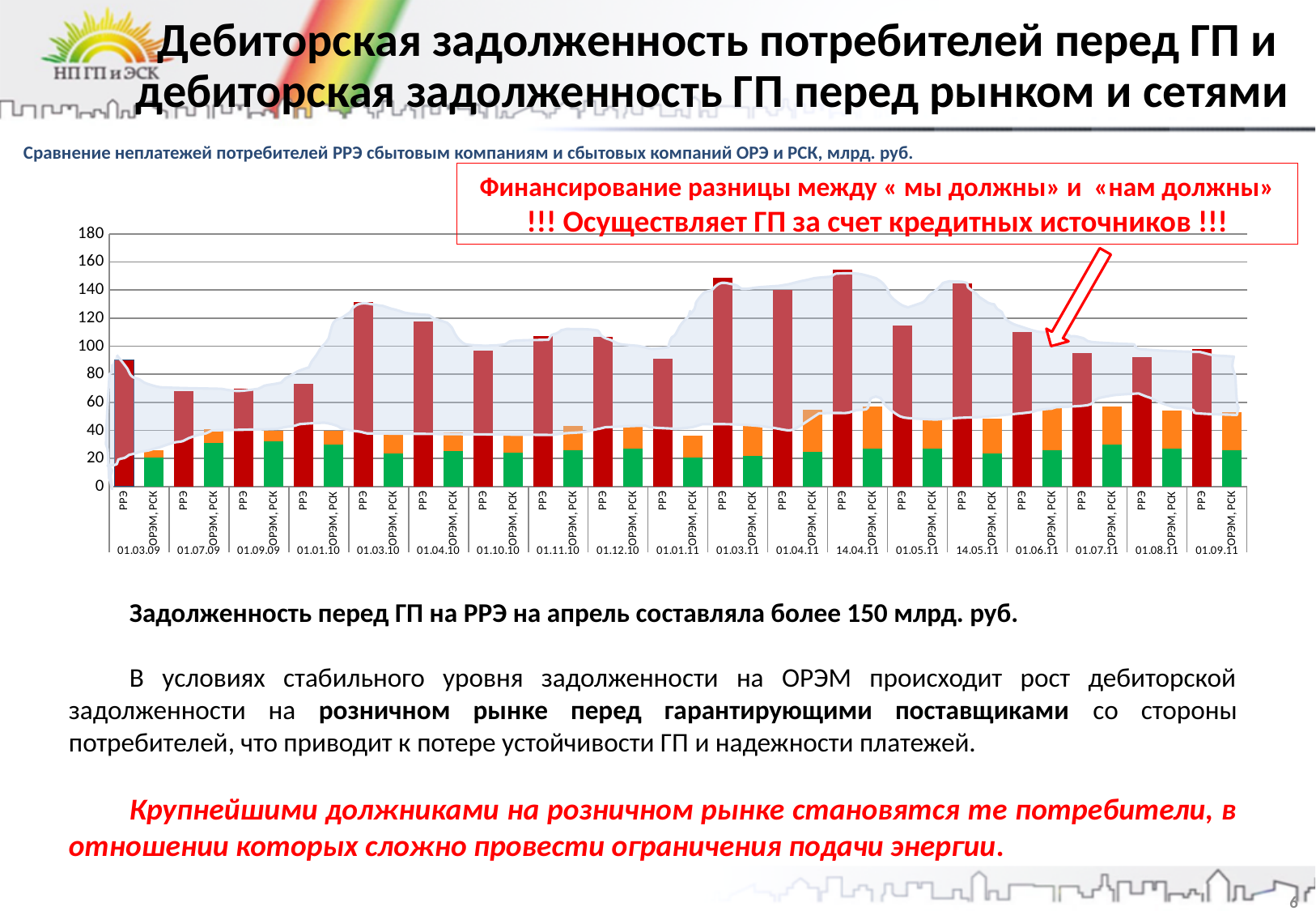
Do the РРЭ values rise or fall from 01.09.09 to 01.03.10? rise Is the РРЭ value for 01.03.09 greater or less than 80? greater What is the highest value shown on the vertical axis of the chart? 180 Is the РРЭ value for 01.05.11 greater or less than 100? greater Is the РРЭ value for 14.04.11 greater or less than 140? greater Which is larger, the РРЭ value for 01.03.10 or the РРЭ value for 01.04.10? 01.03.10 In what units are the values in the chart expressed, according to the chart subtitle? млрд. руб. What kind of chart is shown on the slide? bar chart How many dates are shown along the x axis of the chart? 19